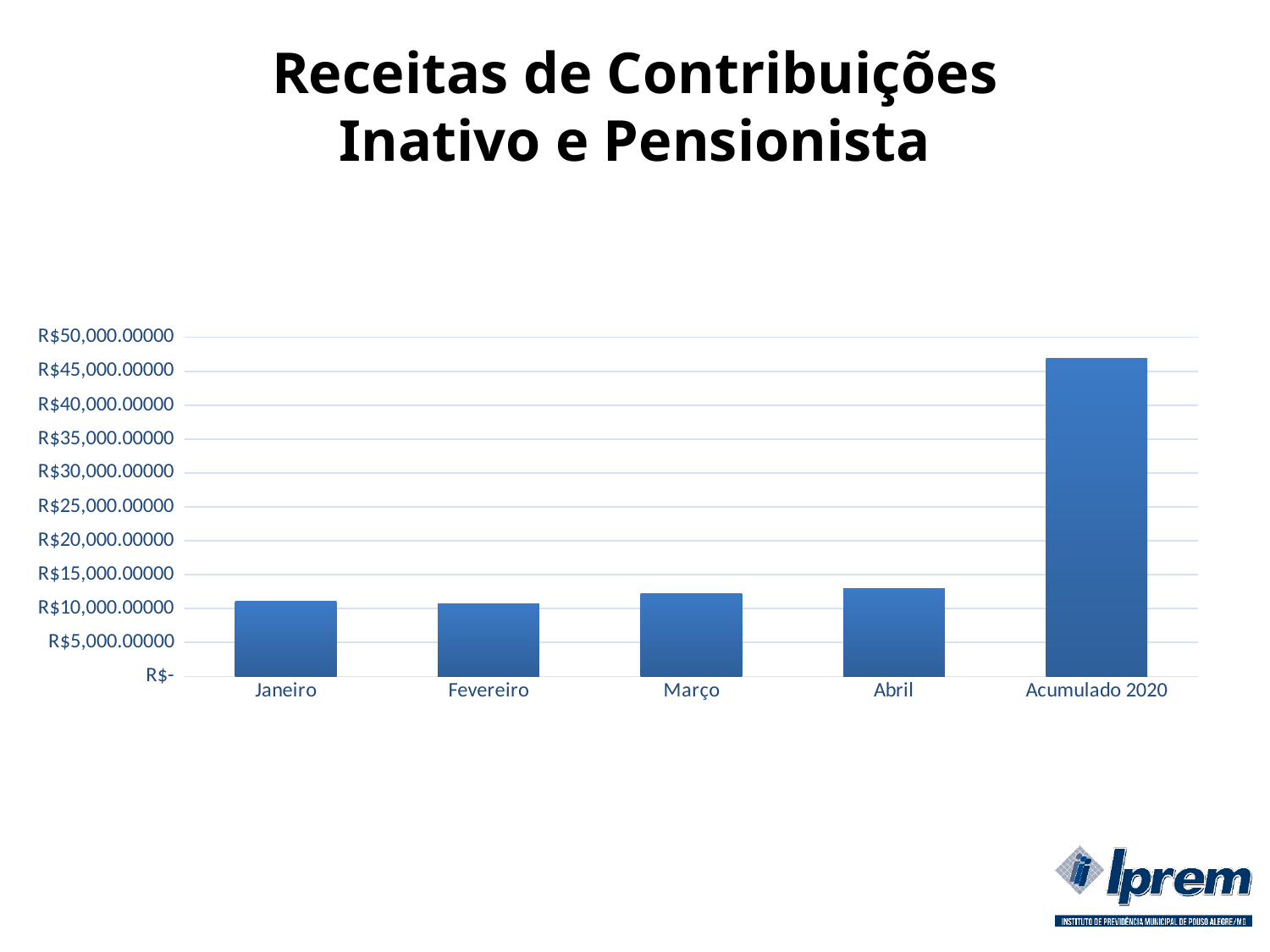
Do the values rise or fall from Fevereiro to Abril? rise Which is larger, the value for Março or the value for Fevereiro? Março Is the value for Acumulado 2020 greater or less than R$50,000.00000? less Is the value for Acumulado 2020 greater or less than R$45,000.00000? greater Which category has the highest value in the chart? Acumulado 2020 How many categories are shown on the x axis of the chart? 5 Is the value for Janeiro greater or less than R$15,000.00000? less What is the title of the chart? Receitas de Contribuições Inativo e Pensionista Which is larger, the value for Abril or the value for Janeiro? Abril What kind of chart is shown on the slide? bar chart